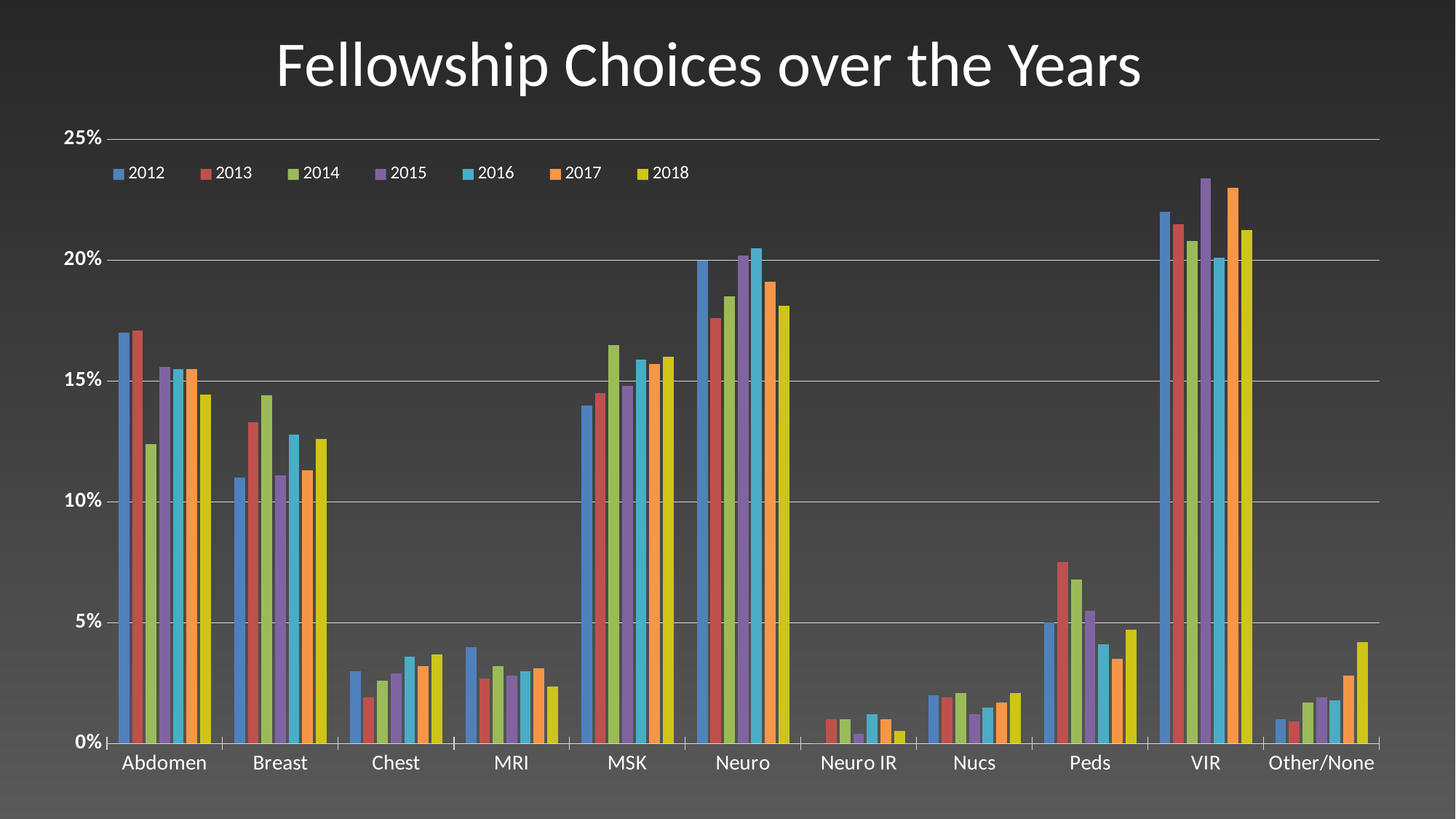
How many fellowship categories are shown on the x axis? 11 Which category has the lowest value for 2018? Neuro IR Which is larger in 2012, the value for Neuro or the value for Breast? Neuro Is the value for Abdomen in 2014 greater or less than 15%? less What kind of chart is shown on the slide? bar chart What is the title of the chart? Fellowship Choices over the Years Is the value for MSK in 2014 greater or less than 15%? greater How many series does the legend list? 7 Which category has the highest value for 2015? VIR Is the value for Peds in 2013 greater or less than 5%? greater For Abdomen, which is larger, the 2012 value or the 2018 value? 2012